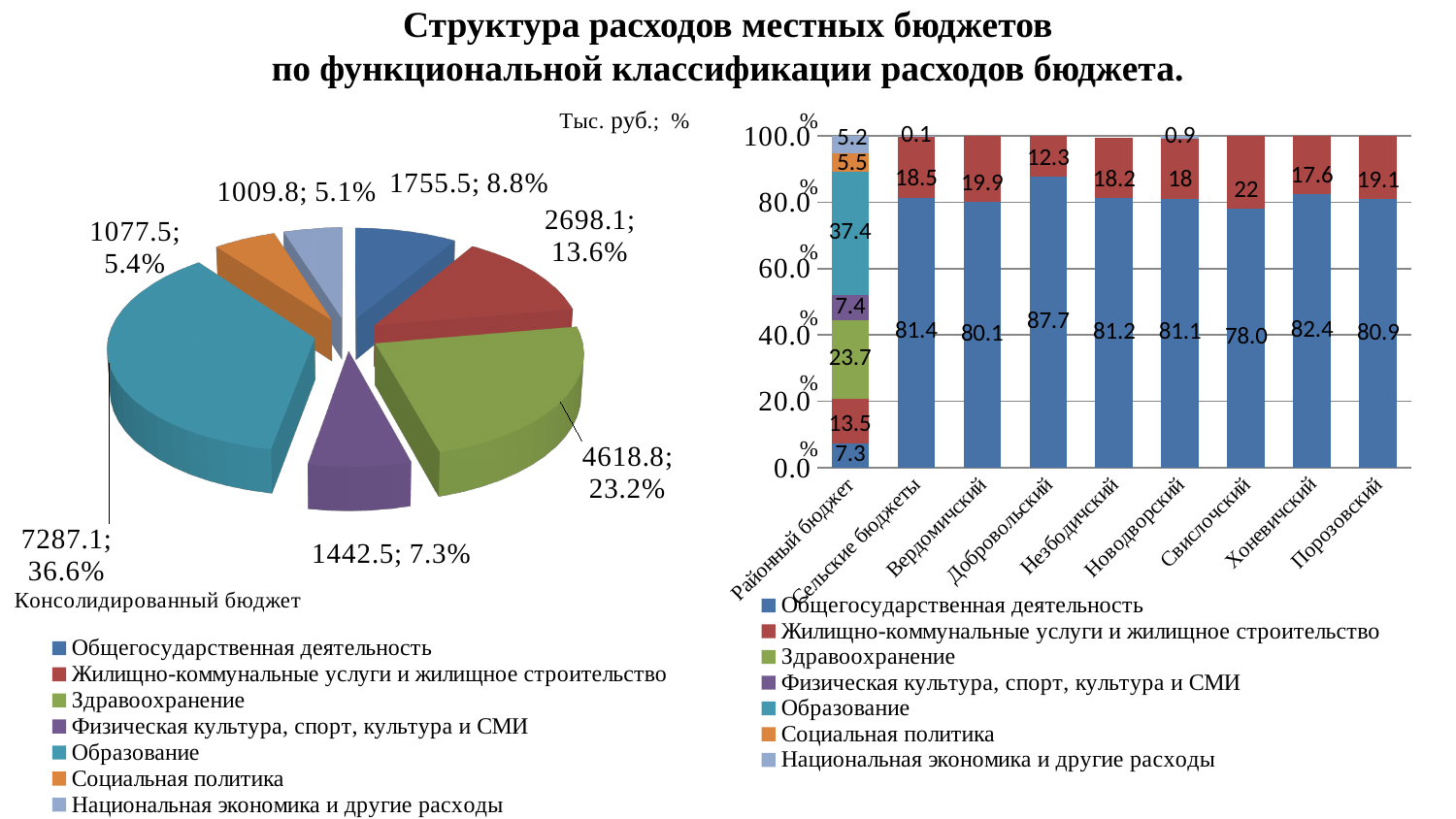
In the pie chart on the left, which category has the smallest share? Национальная экономика и другие расходы In the stacked bar chart on the right, which is larger: the Жилищно-коммунальные услуги value for Свислочский or for Добровольский? Свислочский In the pie chart on the left, how many slices are there? 7 In the pie chart on the left, what is the value shown for the largest slice (Образование)? 7287.1; 36.6% In the stacked bar chart on the right, what is the value of Общегосударственная деятельность for Добровольский? 87.7 What type of chart is shown on the right side of the slide? Stacked bar chart In the pie chart on the left, what is the difference in thousand rubles between Жилищно-коммунальные услуги и жилищное строительство (2698.1) and Общегосударственная деятельность (1755.5)? 942.6 In the stacked bar chart on the right, how many categories are shown on the x axis? 9 In the stacked bar chart on the right, which category has the lowest value for Общегосударственная деятельность among the rural budgets (excluding Районный бюджет)? Свислочский In the pie chart on the left, what share does Здравоохранение have? 23.2% In the stacked bar chart on the right, what is the value of Образование for Районный бюджет? 37.4 In the stacked bar chart on the right, how many series does the legend list? 7